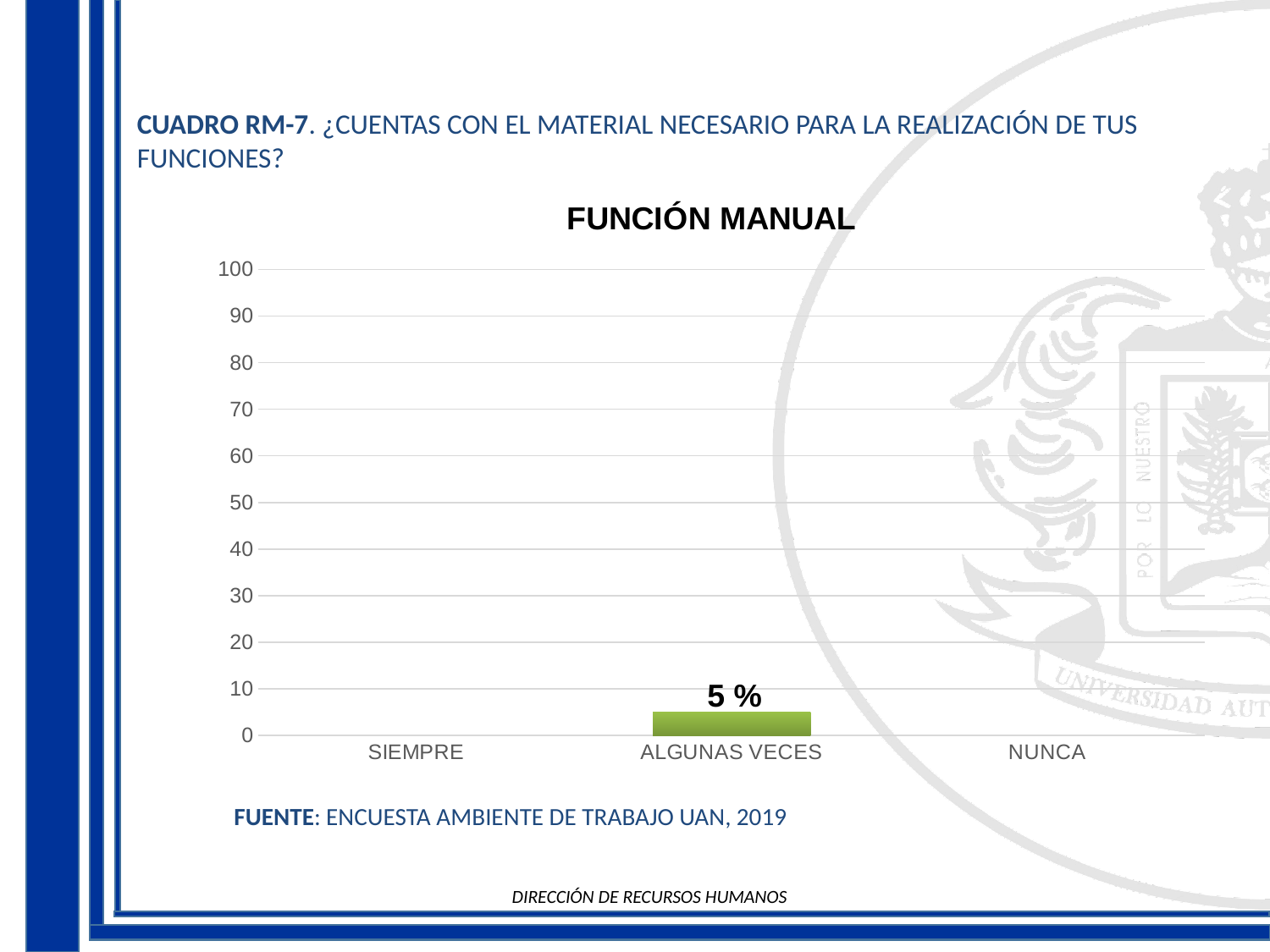
How many categories are listed on the x axis of the chart? 3 Which category on the x axis has a bar with a data label in the chart? ALGUNAS VECES Is the value for ALGUNAS VECES greater or less than 10? less What is the title of the chart? FUNCIÓN MANUAL What are the three categories on the x axis of the chart? SIEMPRE, ALGUNAS VECES, NUNCA What is the value shown for ALGUNAS VECES in the FUNCIÓN MANUAL chart? 5 % What is the highest value shown on the y axis of the chart? 100 What kind of chart is shown on the slide? bar chart